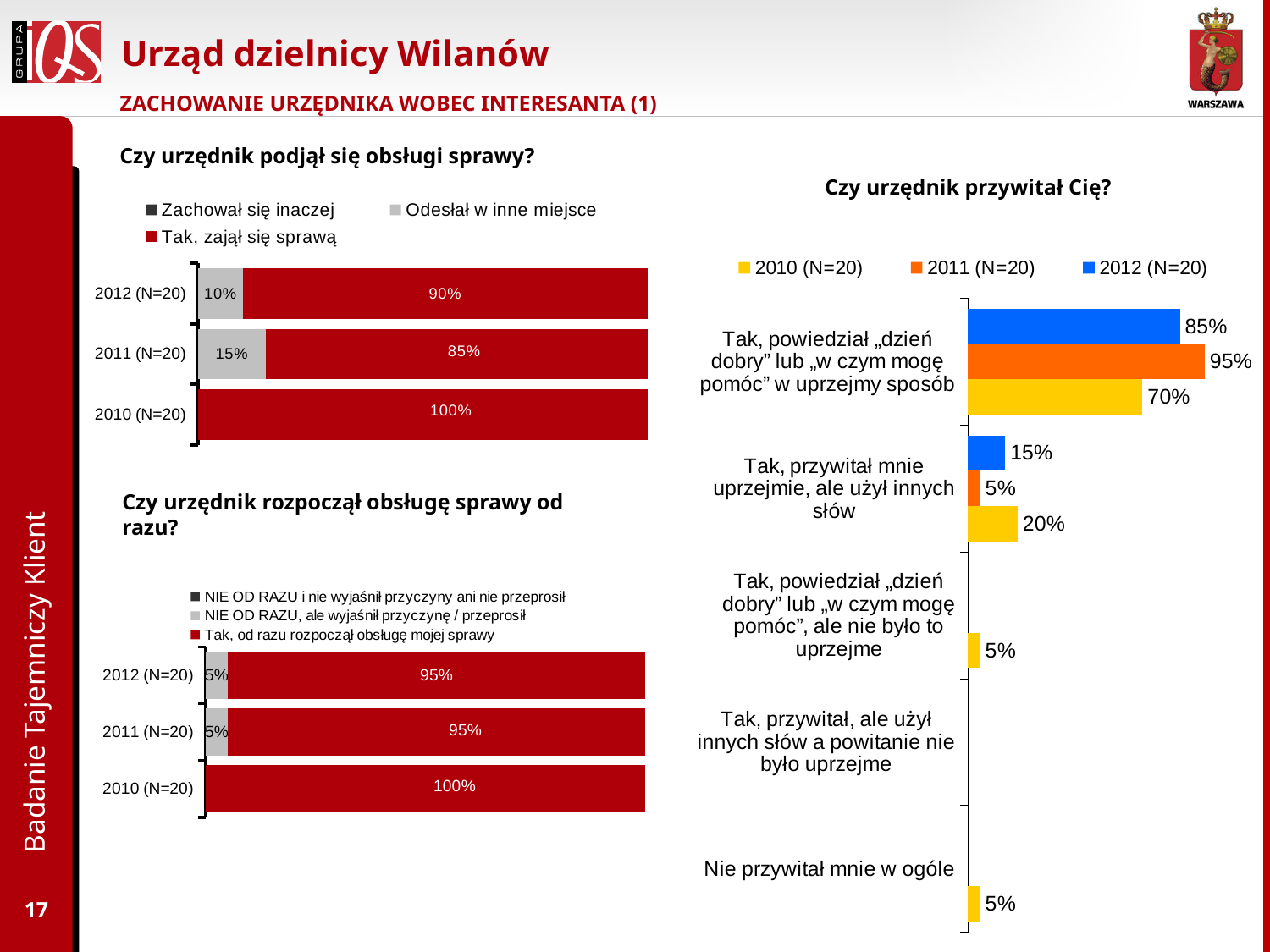
In the chart 'Czy urzędnik podjął się obsługi sprawy?', which year has the highest value for 'Tak, zajął się sprawą'? 2010 (N=20) How many series does the legend of the chart 'Czy urzędnik podjął się obsługi sprawy?' list? 3 In the chart 'Czy urzędnik rozpoczął obsługę sprawy od razu?', what is the value for 'NIE OD RAZU, ale wyjaśnił przyczynę / przeprosił' in 2012 (N=20)? 5% In the chart 'Czy urzędnik podjął się obsługi sprawy?', what is the value for 'Tak, zajął się sprawą' in 2012 (N=20)? 90% How many categories are shown on the y axis of the chart 'Czy urzędnik przywitał Cię?'? 5 In the chart 'Czy urzędnik podjął się obsługi sprawy?', what is the difference between the 'Odesłał w inne miejsce' values for 2011 (N=20) and 2012 (N=20)? 5% In the chart 'Czy urzędnik przywitał Cię?', which year has the lowest value for 'Tak, powiedział „dzień dobry” lub „w czym mogę pomóc” w uprzejmy sposób'? 2010 (N=20) What kind of chart is 'Czy urzędnik rozpoczął obsługę sprawy od razu?'? Stacked bar chart In the chart 'Czy urzędnik przywitał Cię?', what is the 2011 (N=20) value for 'Tak, powiedział „dzień dobry” lub „w czym mogę pomóc” w uprzejmy sposób'? 95% In the chart 'Czy urzędnik rozpoczął obsługę sprawy od razu?', what is the value for 'Tak, od razu rozpoczął obsługę mojej sprawy' in 2011 (N=20)? 95% In the chart 'Czy urzędnik przywitał Cię?', which is larger for 'Tak, przywitał mnie uprzejmie, ale użył innych słów': the 2010 (N=20) value or the 2012 (N=20) value? 2010 (N=20) In the chart 'Czy urzędnik podjął się obsługi sprawy?', what is the value for 'Odesłał w inne miejsce' in 2011 (N=20)? 15%